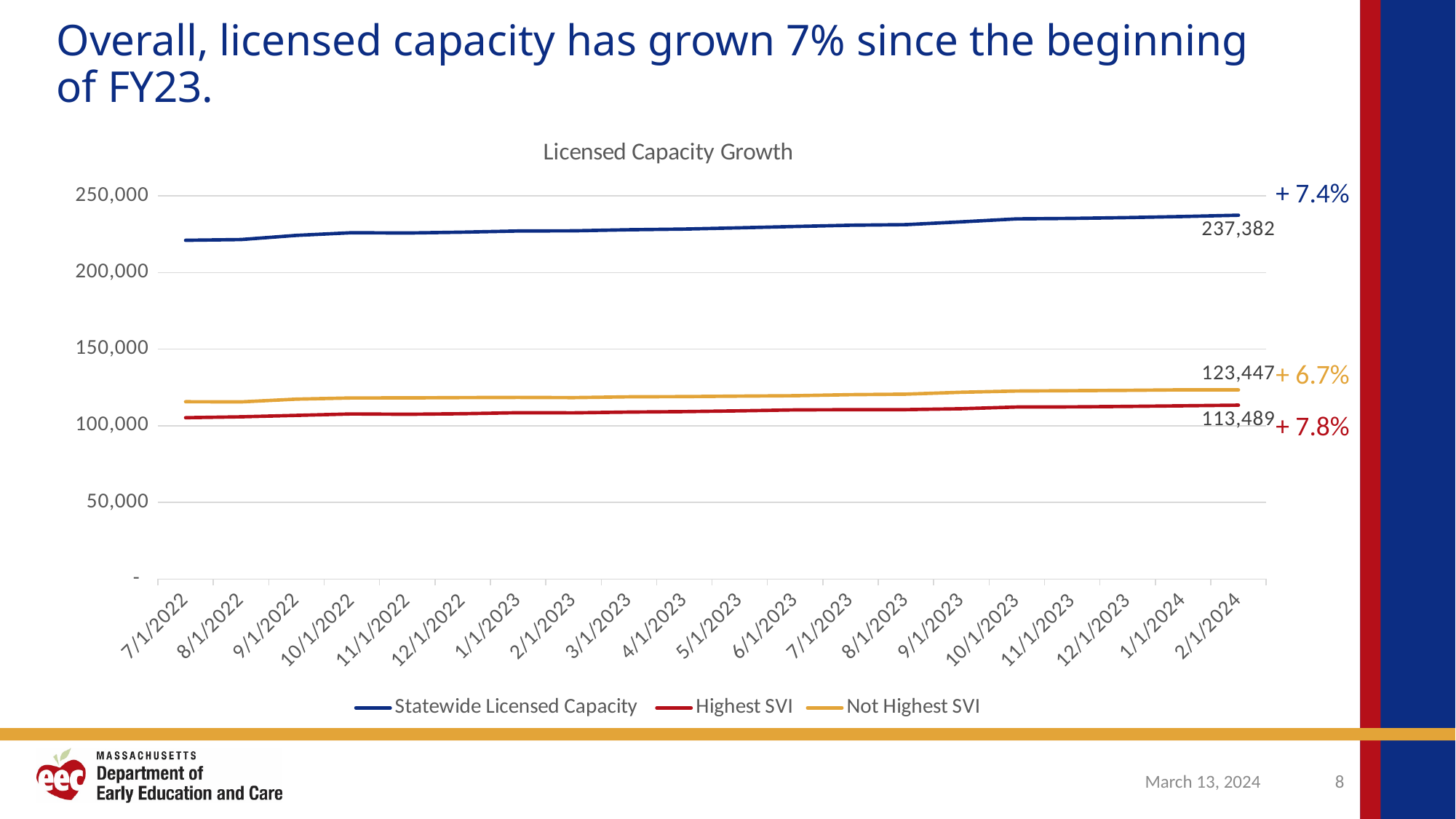
Which series has the highest value at 2/1/2024? Statewide Licensed Capacity How many dates are shown on the x axis of the chart? 20 What is the Highest SVI value labeled at 2/1/2024? 113,489 At 2/1/2024, which is larger: Highest SVI or Not Highest SVI? Not Highest SVI What type of chart is shown on the slide? line chart What is the Not Highest SVI value labeled at 2/1/2024? 123,447 How many series does the legend of the Licensed Capacity Growth chart list? 3 What is the difference between the Not Highest SVI and Highest SVI values labeled at 2/1/2024? 9,958 What percentage growth is annotated next to the Highest SVI line? + 7.8% Is the Highest SVI value at 7/1/2022 greater or less than 100,000? greater Does the Statewide Licensed Capacity line rise or fall from 7/1/2022 to 2/1/2024? rise What is the Statewide Licensed Capacity value labeled at 2/1/2024? 237,382